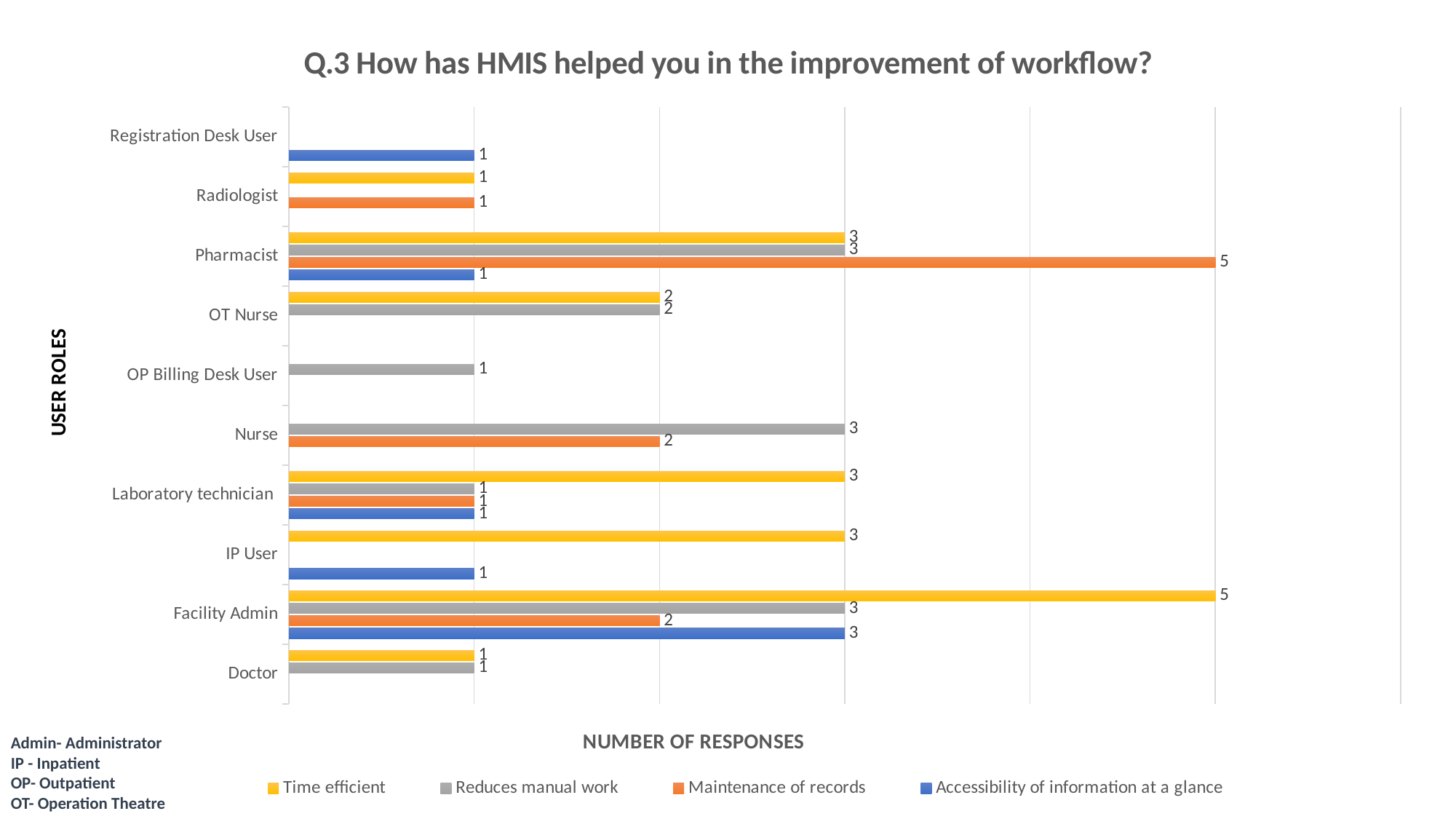
Which has a larger Maintenance of records value, Pharmacist or Facility Admin? Pharmacist How many responses did Pharmacist give for Maintenance of records? 5 How many series does the legend list? 4 What is the difference between the Time efficient and Maintenance of records values for Facility Admin? 3 What is the total number of responses across all four series for Facility Admin? 13 What is the Reduces manual work value for OT Nurse? 2 What is the Time efficient value for Laboratory technician? 3 Which user role has the highest Time efficient value? Facility Admin What is the Time efficient value for Facility Admin? 5 What kind of chart is shown on the slide? Bar chart How many user roles are listed on the y axis? 10 What is the Reduces manual work value for Nurse? 3